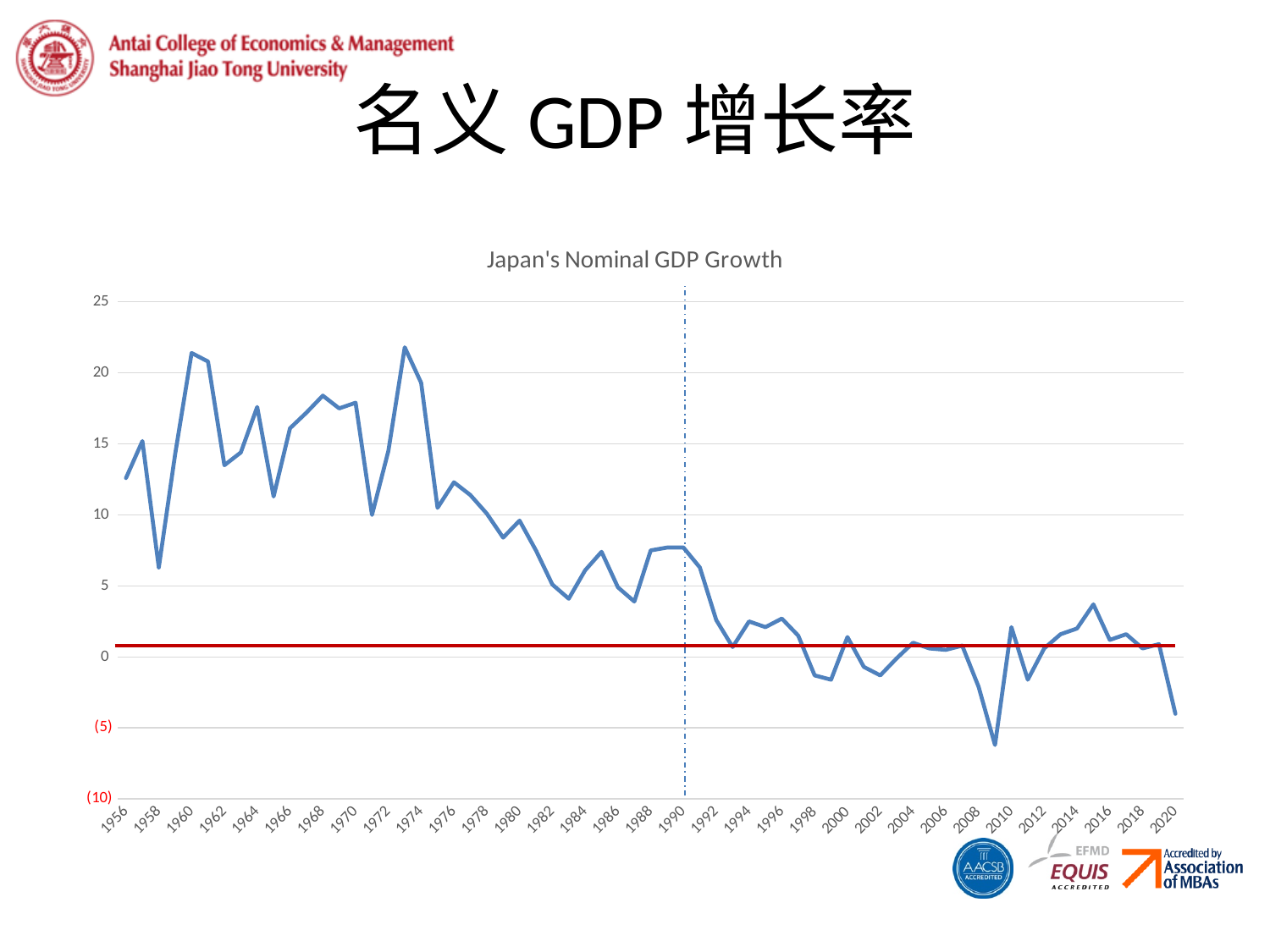
Is the value for 2009 greater or less than (5)? less Is the value for 1973 greater or less than 20? greater Is the value for 2020 greater or less than 0? less Overall, do the values rise or fall from 1956 to 2020? fall What kind of chart is shown on the slide? line chart Which year has the larger value, 1960 or 1958? 1960 What is the title of the chart? Japan's Nominal GDP Growth Which year has the larger value, 1966 or 1986? 1966 Which year has the lowest nominal GDP growth in the chart? 2009